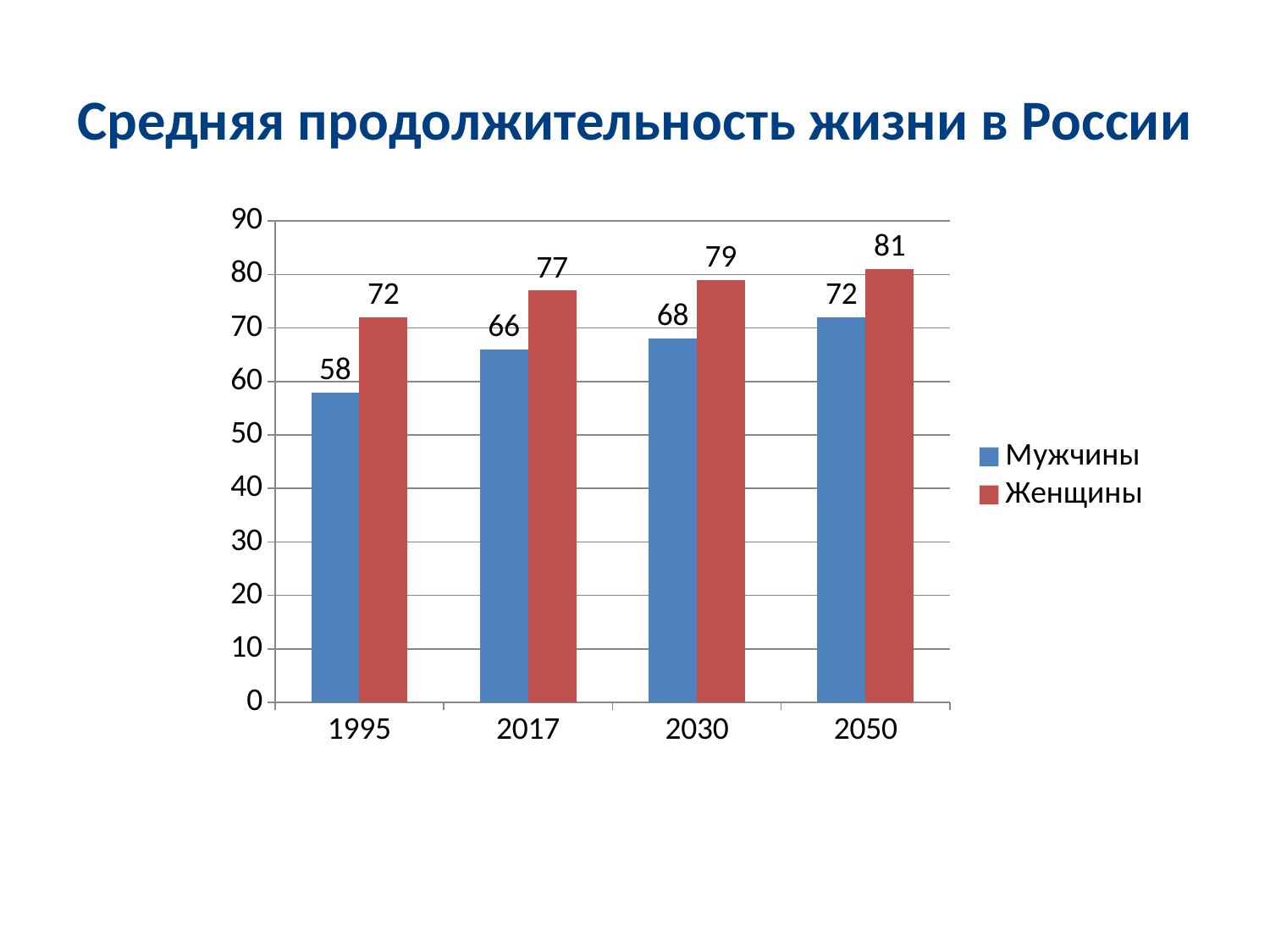
In which year is the value for Женщины highest? 2050 Which is larger in 2030: Мужчины or Женщины? Женщины How many series does the legend list? 2 What kind of chart is shown on the slide? Bar chart Do the values for Мужчины rise or fall from 1995 to 2050? Rise What is the value for Мужчины in 1995? 58 What is the value for Мужчины in 2030? 68 How many years are shown on the x axis? 4 In which year is the value for Мужчины lowest? 1995 What is the value for Женщины in 2050? 81 What is the difference between the Мужчины values for 2050 and 1995? 14 What is the difference between Женщины and Мужчины in 2017? 11